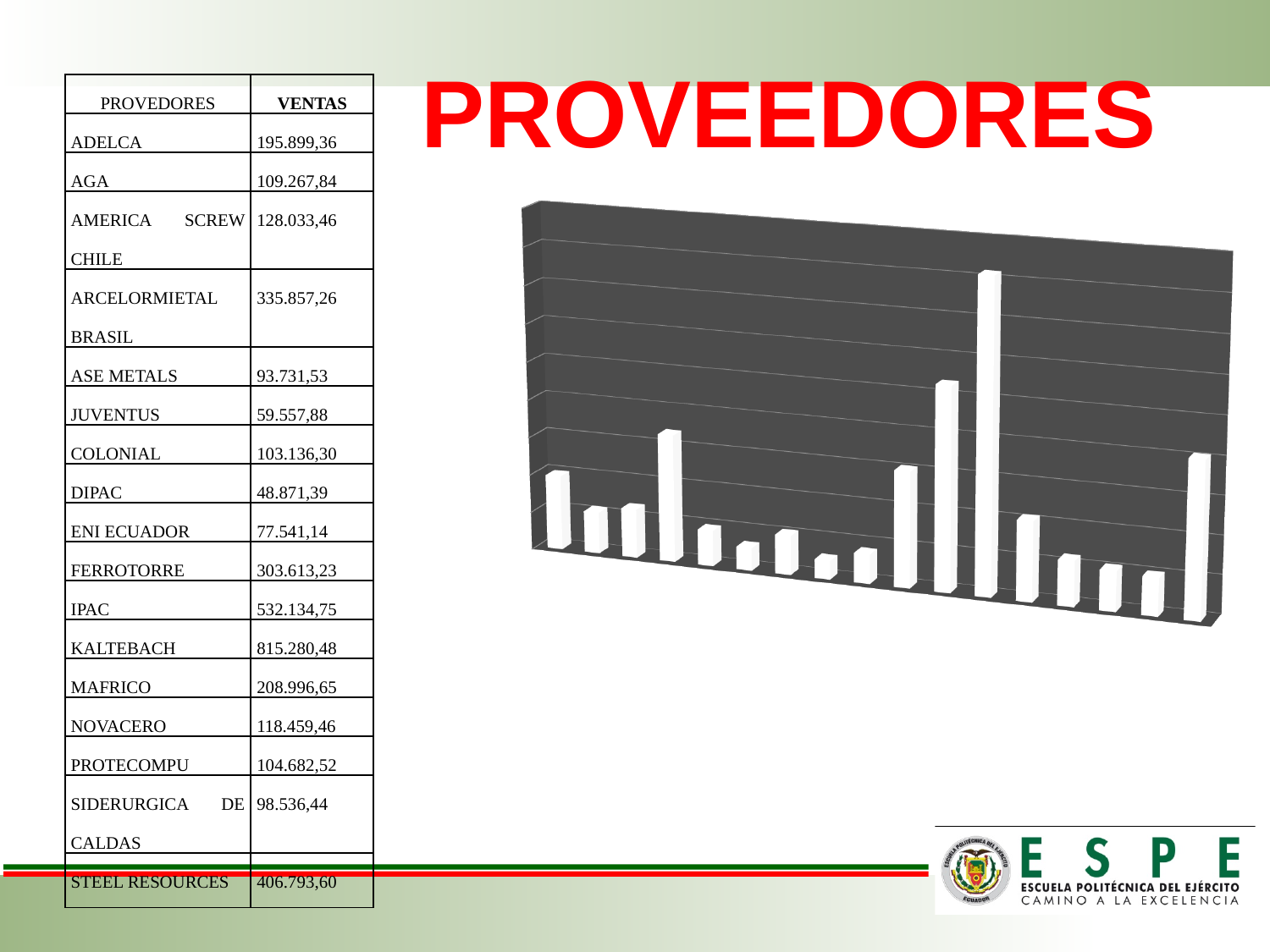
Counting from the left, which bar in the chart is the second tallest? the 11th bar Does the chart display a legend? No How many bars does the chart contain? 17 What kind of chart is shown on the slide? bar chart Does the chart show any axis labels or data labels? No Counting from the left, which bar in the chart is the tallest? the 12th bar Is the 11th bar from the left taller or shorter than the last (17th) bar? taller Is the 4th bar from the left taller or shorter than the 10th bar from the left? taller